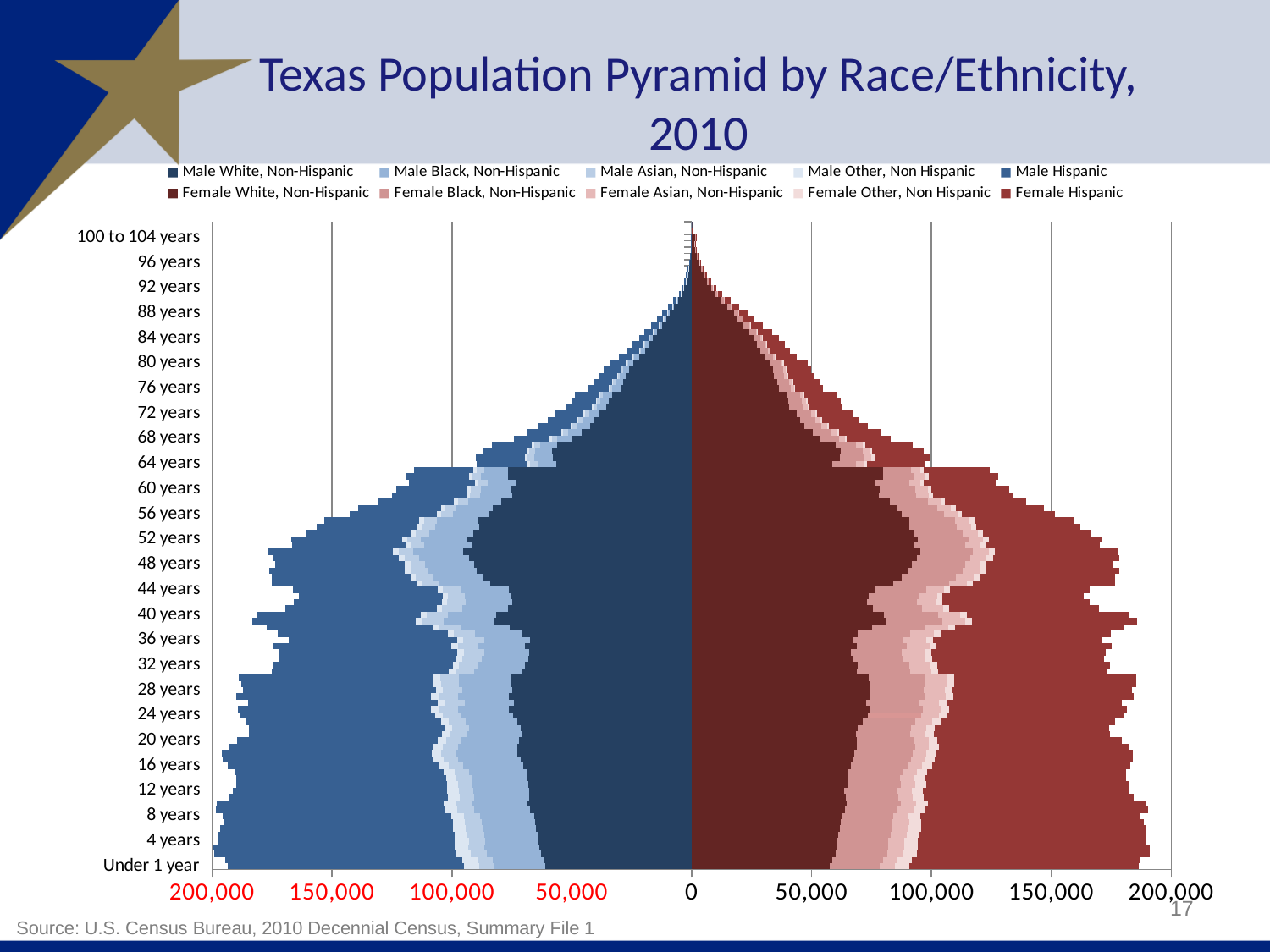
Is the Male Hispanic segment larger at Under 1 year or at 64 years? Under 1 year Is the total female population at 84 years greater or less than 50,000? less According to the note below the chart, what is the data source? U.S. Census Bureau, 2010 Decennial Census, Summary File 1 Moving from 48 years up to 100 to 104 years, do the total bar lengths generally rise or fall? fall Is the total male population at 80 years greater or less than 50,000? less What is the title of the chart? Texas Population Pyramid by Race/Ethnicity, 2010 What type of chart is shown on the slide? Bar chart (population pyramid) How many series does the legend list? 10 Is the total female population at 92 years greater or less than 50,000? less Is the total female population larger at 4 years or at 80 years? 4 years